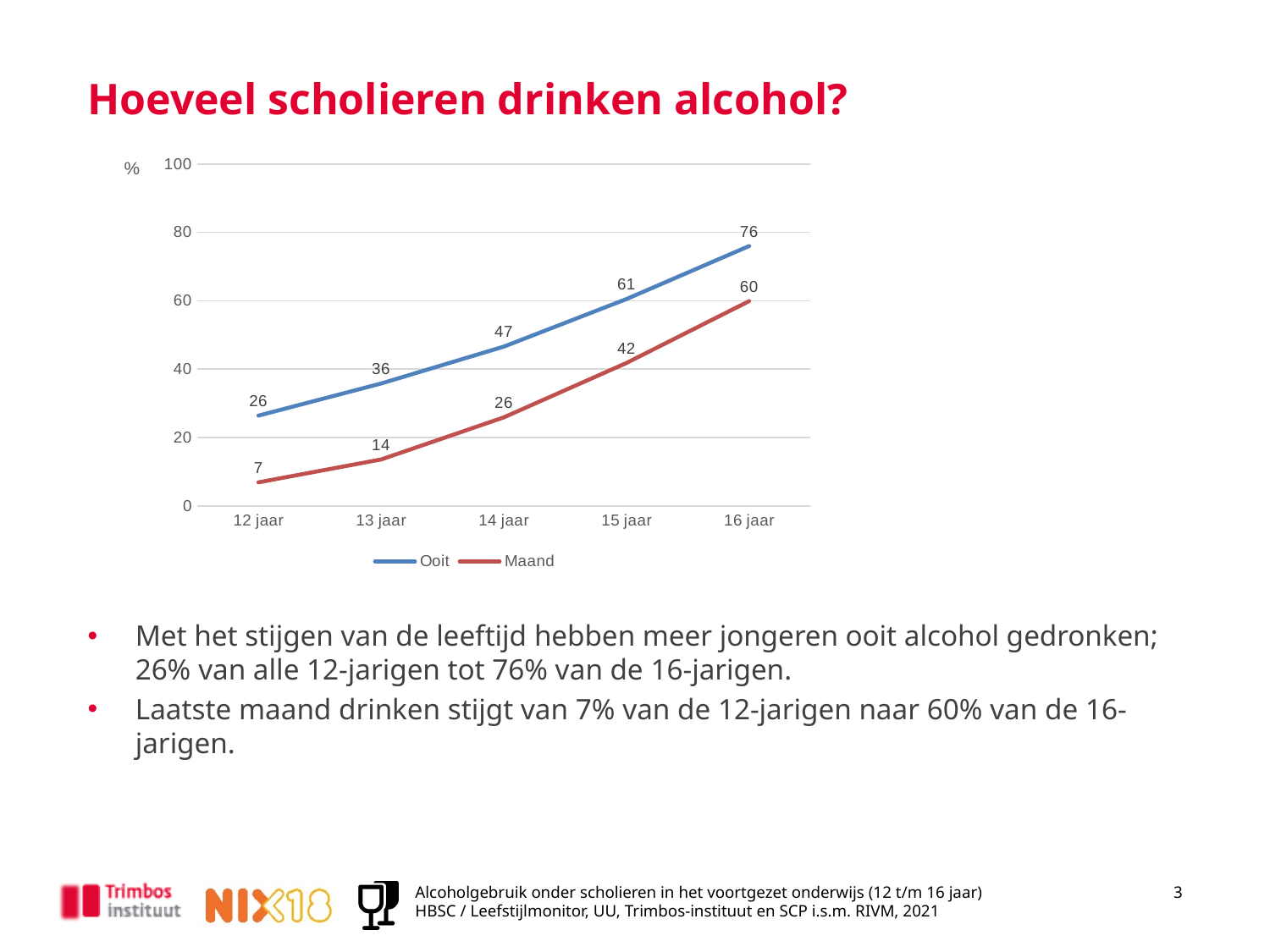
Do the Maand values rise or fall from 12 jaar to 16 jaar? Rise How many age categories are shown on the x axis? 5 What is the value for Ooit at 14 jaar? 47 How many series does the legend list? 2 What is the value for Maand at 16 jaar? 60 Which is larger at 12 jaar: Ooit or Maand? Ooit What is the difference between Ooit and Maand at 15 jaar? 19 What kind of chart is shown on the slide? Line chart What is the value for Maand at 13 jaar? 14 What colour is the Maand line? Red At which age is the Ooit value highest? 16 jaar At which age is the Maand value lowest? 12 jaar